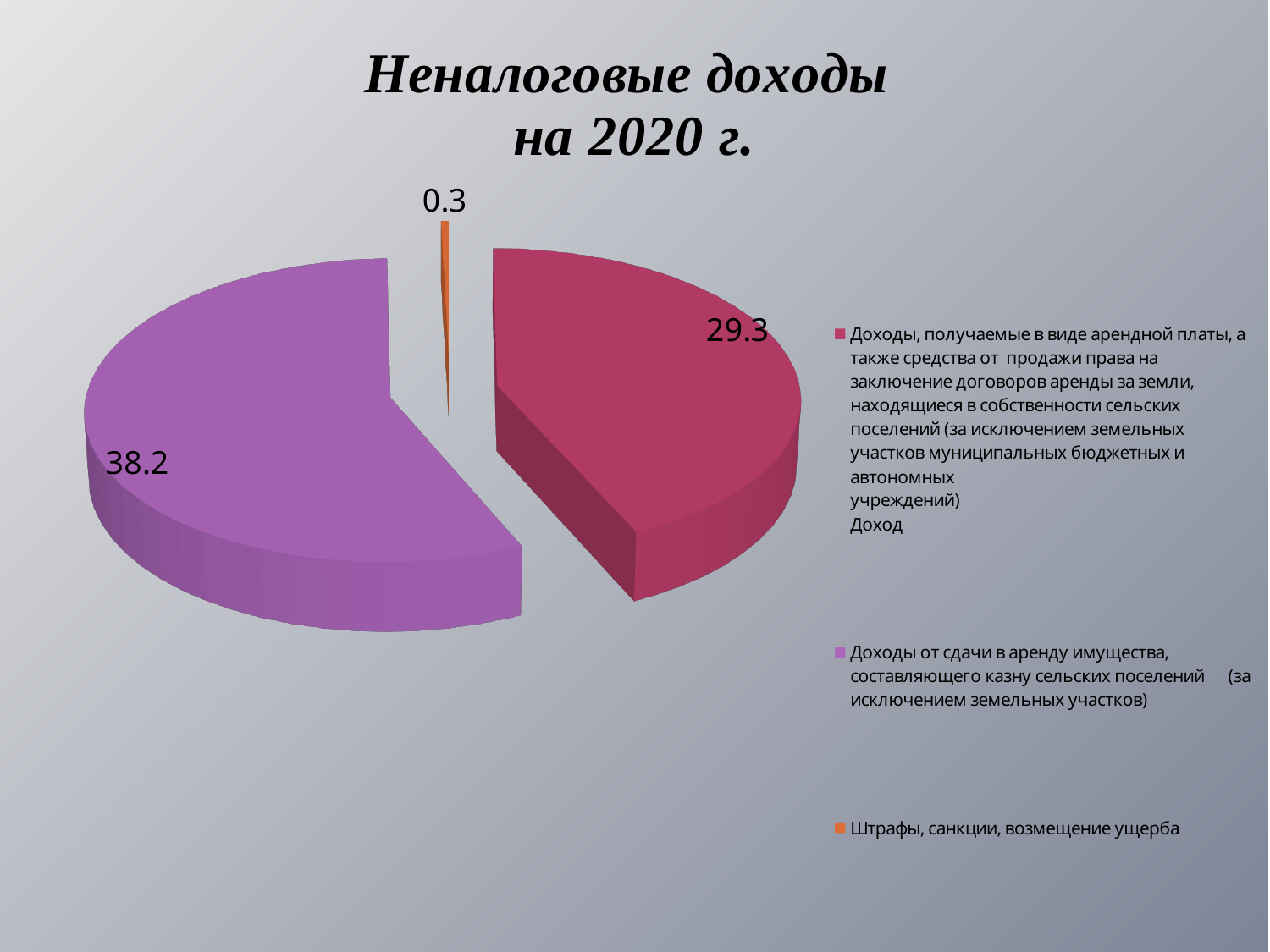
Which category has the smallest slice of the pie? Штрафы, санкции, возмещение ущерба What kind of chart is shown on the slide? Pie chart What value is shown for the slice "Доходы от сдачи в аренду имущества, составляющего казну сельских поселений (за исключением земельных участков)"? 38.2 What is the total of all three values shown on the pie chart? 67.8 What is the difference between the value for "Доходы от сдачи в аренду имущества..." (38.2) and the value for "Доходы, получаемые в виде арендной платы..." (29.3)? 8.9 What value is shown for the slice "Доходы, получаемые в виде арендной платы, а также средства от продажи права на заключение договоров аренды за земли..."? 29.3 Which category has the largest slice of the pie? Доходы от сдачи в аренду имущества, составляющего казну сельских поселений (за исключением земельных участков) How many entries does the legend list? 3 How many slices does the pie chart have? 3 Which is larger: the value for "Доходы, получаемые в виде арендной платы..." or the value for "Штрафы, санкции, возмещение ущерба"? Доходы, получаемые в виде арендной платы... What value is shown for the slice "Штрафы, санкции, возмещение ущерба"? 0.3 What is the title of the chart on the slide? Неналоговые доходы на 2020 г.